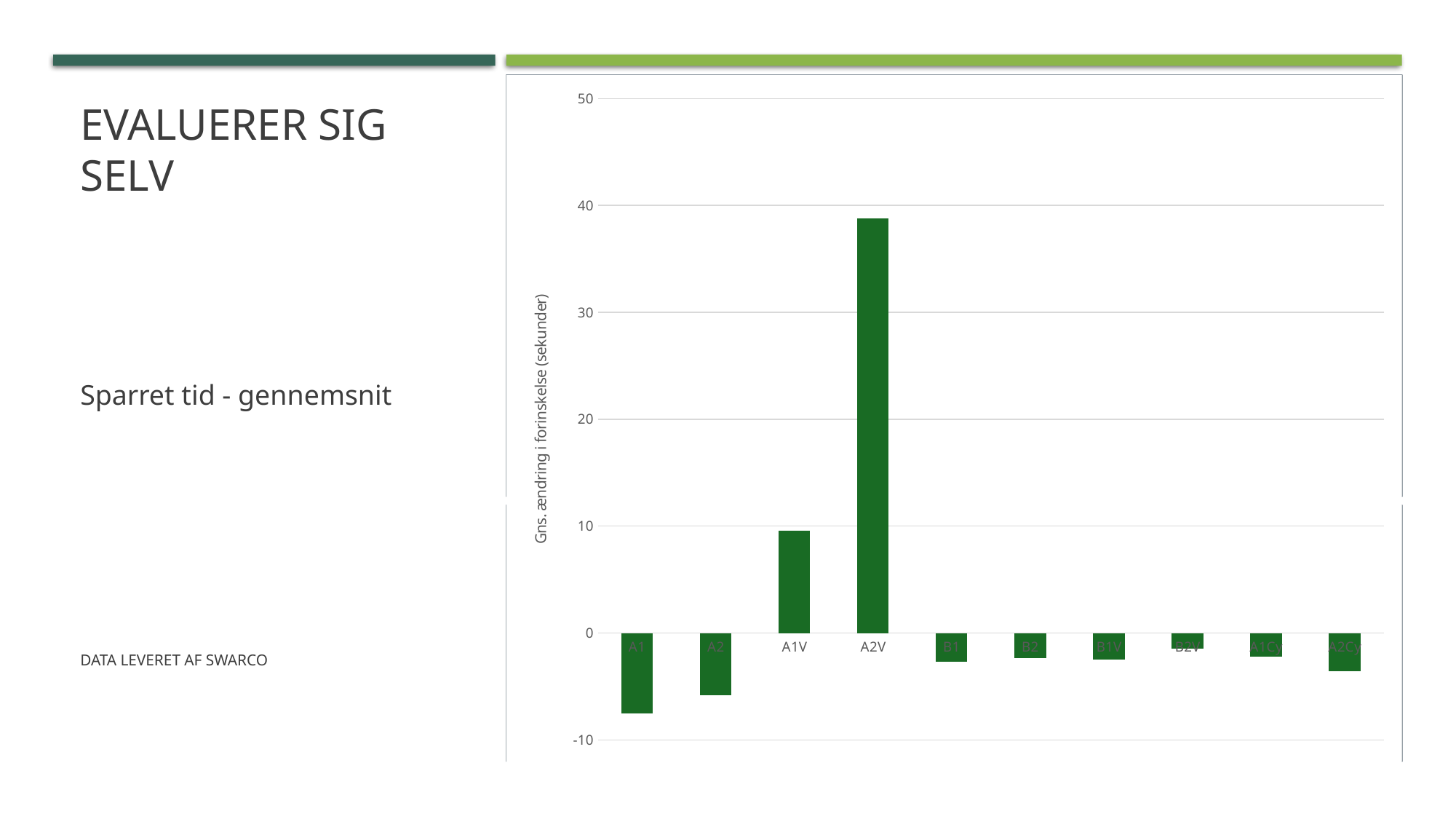
How many categories on the chart have a value above 0? 2 How many categories are plotted on the chart? 10 What kind of chart is shown on the slide? Bar chart What is the label on the vertical axis of the chart? Gns. ændring i forinskelse (sekunder) Which category has the lowest value on the chart? A1 Which category has the highest value on the chart? A2V Which is larger, the value for A1V or the value for A2V? A2V Is the value for A1V greater or less than 20? less What colour are the bars on the chart? Green Is the value for A2V greater or less than 30? greater Is the value for A1 greater or less than 0? less